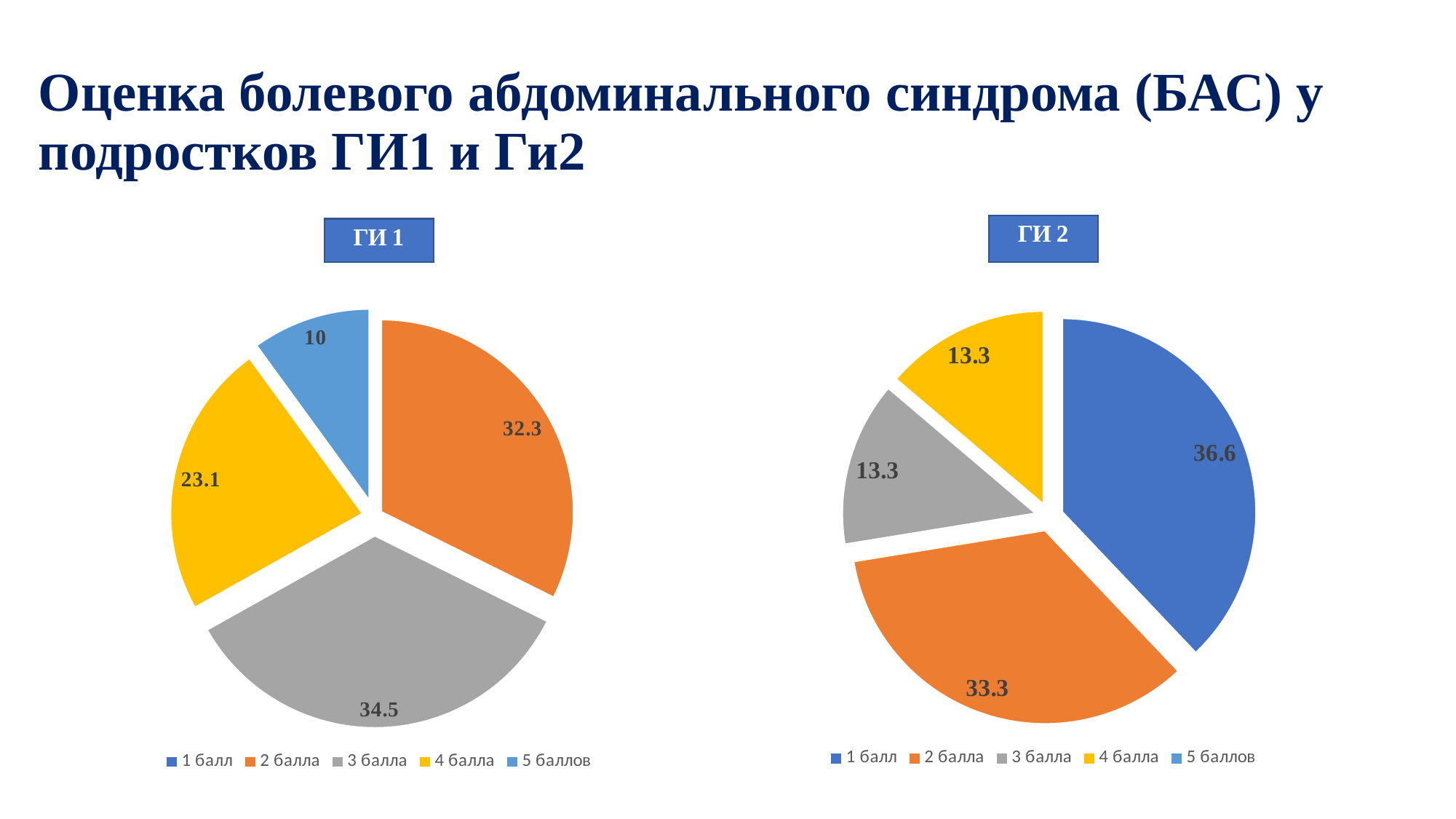
In the ГИ 2 pie chart, what is the value for 1 балл? 36.6 In the ГИ 2 pie chart, what is the difference between the values for 1 балл and 3 балла? 23.3 In the ГИ 1 pie chart, which category has the smallest slice? 5 баллов What type of chart is used for ГИ 1? Pie chart In the ГИ 1 pie chart, what is the value for 3 балла? 34.5 In the ГИ 2 pie chart, which category has the largest slice? 1 балл In the ГИ 1 pie chart, which category has the largest slice? 3 балла In the ГИ 1 pie chart, what is the difference between the values for 3 балла and 4 балла? 11.4 In the ГИ 2 pie chart, what is the value for 2 балла? 33.3 In the ГИ 1 pie chart, what is the value for 5 баллов? 10 How many slices are shown in the ГИ 2 pie chart? 4 In the ГИ 1 pie chart, which is larger: the value for 2 балла or the value for 4 балла? 2 балла